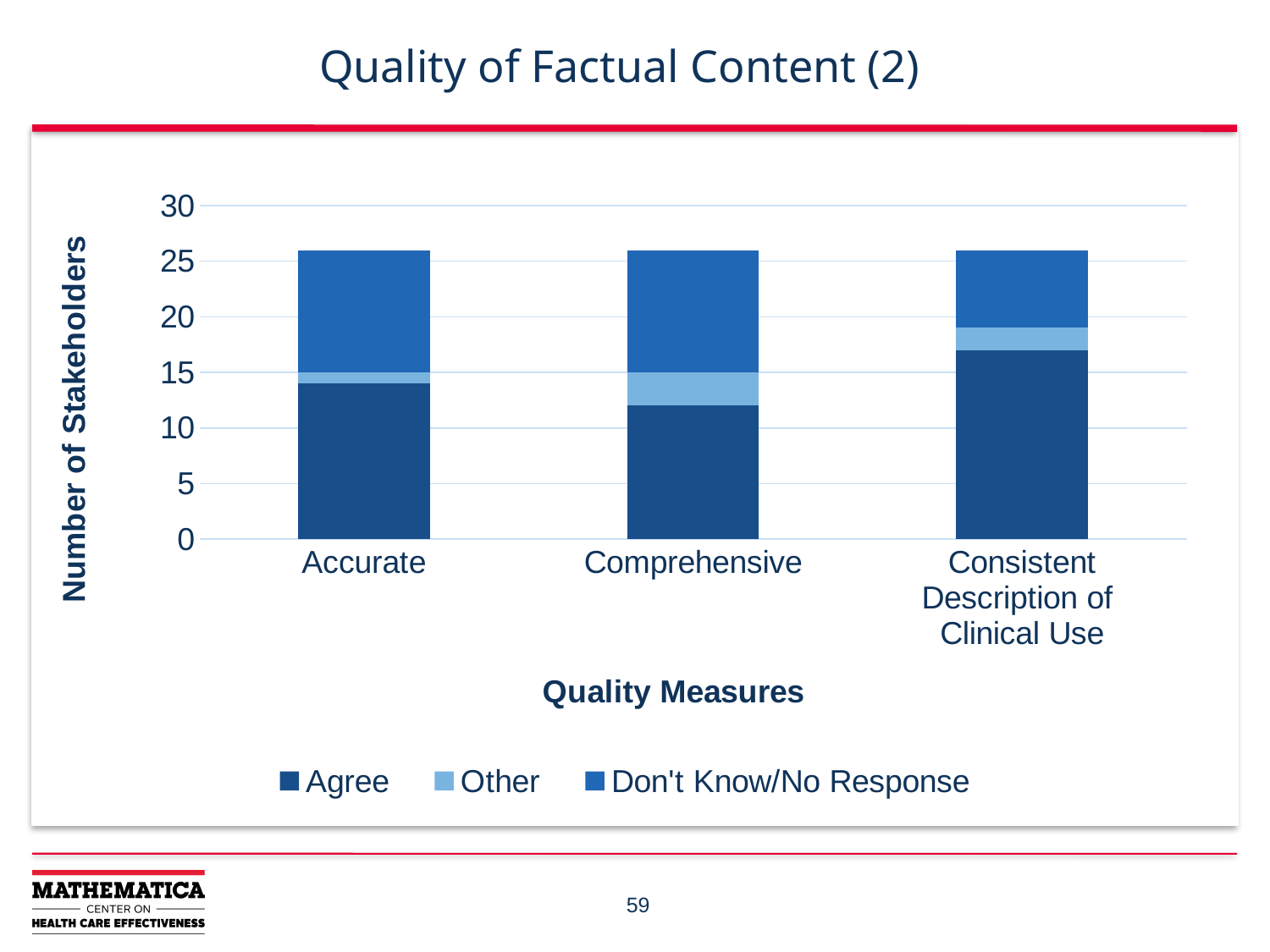
Is the total height of the Accurate bar greater or less than 25? greater Is the Agree segment larger for Accurate or for Comprehensive? Accurate What is the title of the chart on the slide? Quality of Factual Content (2) Which quality measure has the smallest Don't Know/No Response segment? Consistent Description of Clinical Use What kind of chart is shown on the slide? Stacked bar chart Which quality measure has the smallest Agree segment? Comprehensive Is the Agree value for Consistent Description of Clinical Use greater or less than 15? greater How many series does the legend list? 3 What is the label of the vertical axis? Number of Stakeholders How many quality measures (categories) are shown on the x axis? 3 Which quality measure has the largest Agree segment? Consistent Description of Clinical Use Is the Agree value for Comprehensive greater or less than 15? less